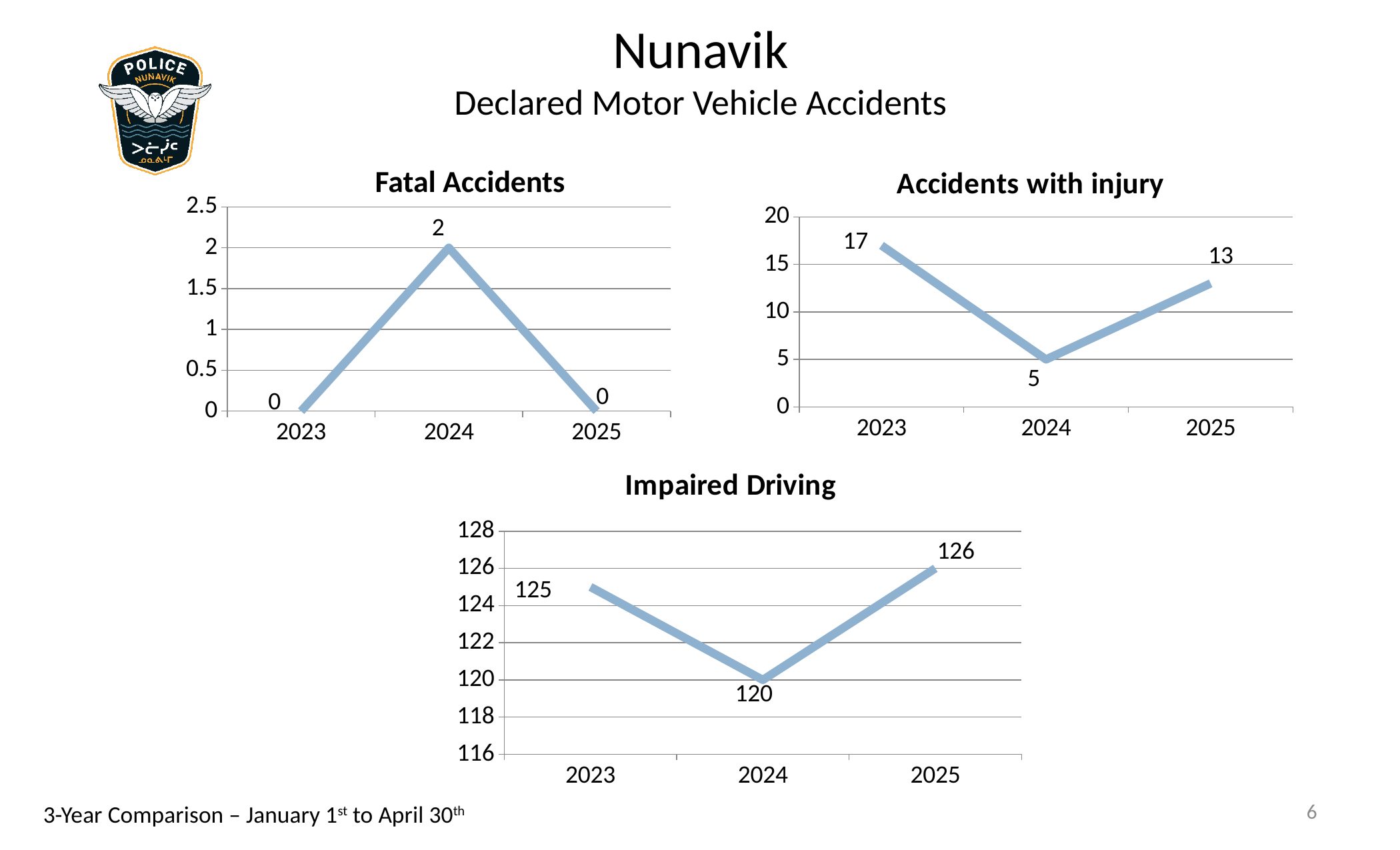
In the Impaired Driving chart, what is the value for 2024? 120 In the Impaired Driving chart, what is the difference between the 2025 and 2024 values? 6 In the Impaired Driving chart, is the value for 2023 larger or the value for 2025? 2025 In the Accidents with injury chart, which year has the lowest value? 2024 In the Fatal Accidents chart, which year has the highest value? 2024 In the Impaired Driving chart, which year has the highest value? 2025 What kind of chart is the Impaired Driving chart? Line chart How many data points are plotted in the Accidents with injury chart? 3 In the Accidents with injury chart, does the value rise or fall from 2024 to 2025? Rise In the Accidents with injury chart, what is the value for 2023? 17 In the Fatal Accidents chart, what is the value for 2024? 2 In the Accidents with injury chart, what is the difference between the 2023 and 2025 values? 4